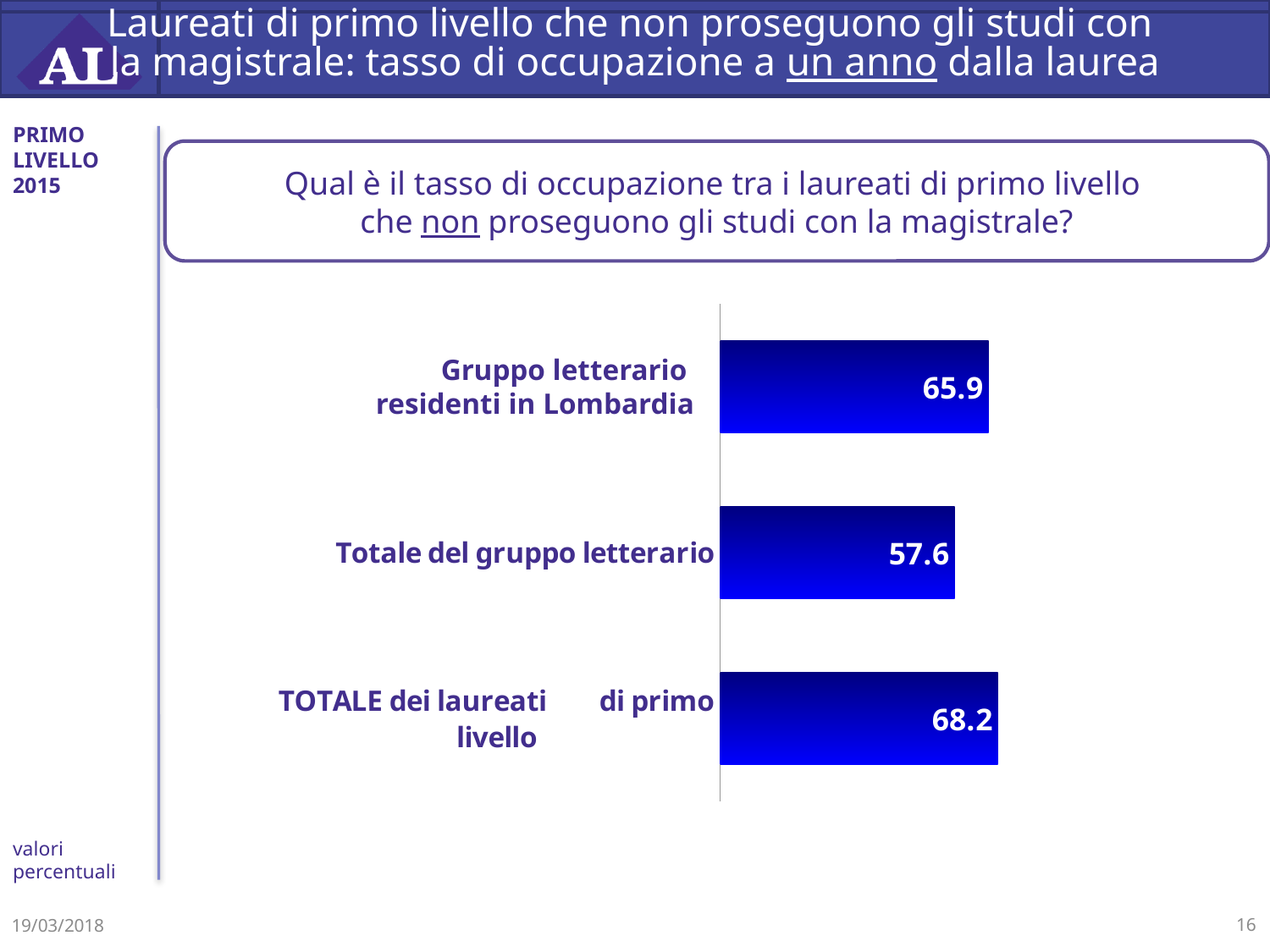
In what unit are the chart values expressed, according to the note at the bottom left of the slide? valori percentuali What is the value for Gruppo letterario residenti in Lombardia? 65.9 What is the value for Totale del gruppo letterario? 57.6 Which is larger: the value for Gruppo letterario residenti in Lombardia or the value for Totale del gruppo letterario? Gruppo letterario residenti in Lombardia Which category has the lowest value? Totale del gruppo letterario How many categories are shown in the chart? 3 Which category has the highest value? TOTALE dei laureati di primo livello Which is larger: the value for TOTALE dei laureati di primo livello or the value for Gruppo letterario residenti in Lombardia? TOTALE dei laureati di primo livello What kind of chart is shown on the slide? bar chart What is the difference between the value for TOTALE dei laureati di primo livello and the value for Totale del gruppo letterario? 10.6 What is the difference between the value for Gruppo letterario residenti in Lombardia and the value for Totale del gruppo letterario? 8.3 What is the value for TOTALE dei laureati di primo livello? 68.2